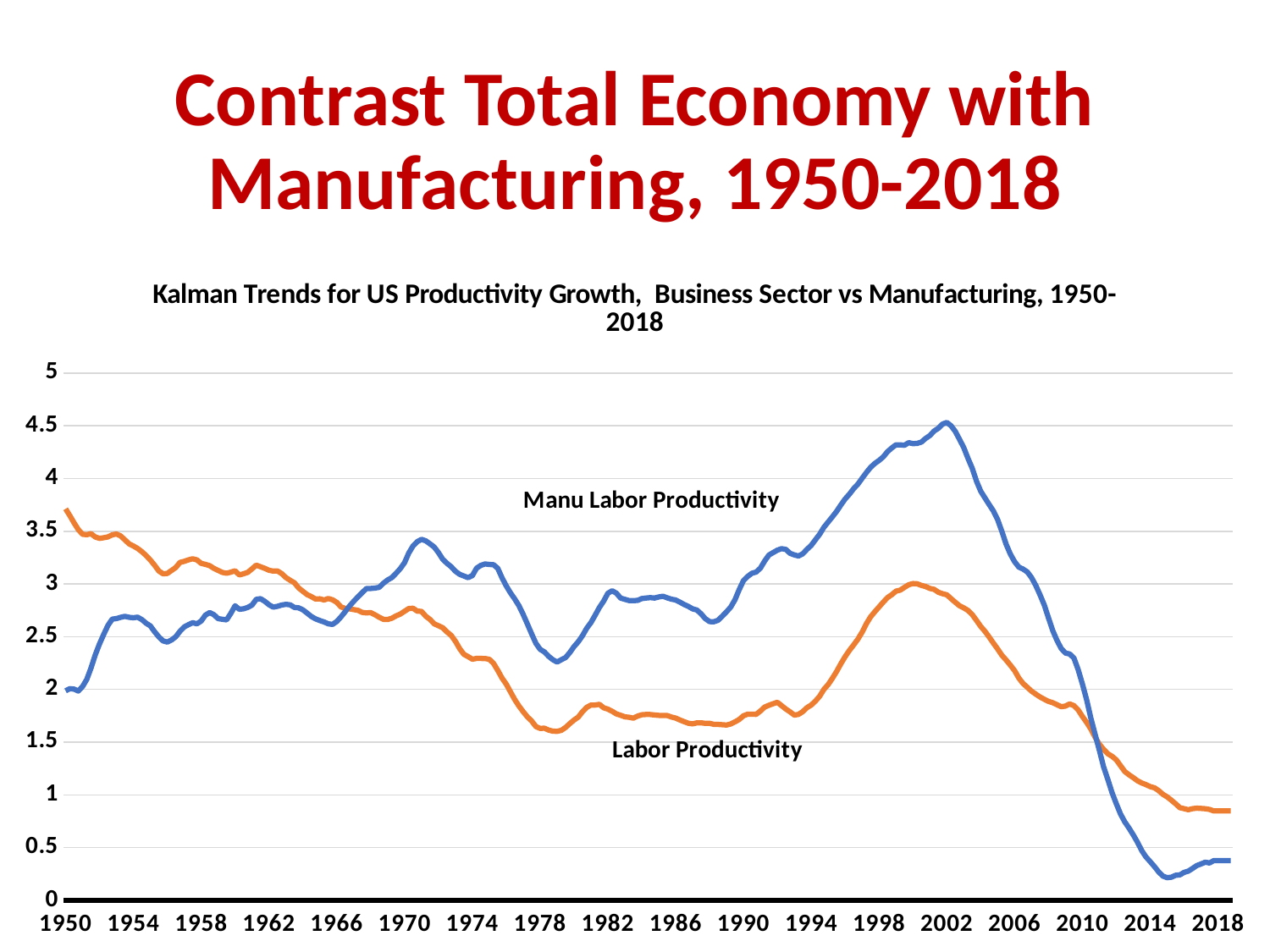
Is the value for Manu Labor Productivity in 2014 greater or less than 1? less Is the value for Manu Labor Productivity in 2002 greater or less than 4? greater In 2014, which series has the higher value, Manu Labor Productivity or Labor Productivity? Labor Productivity What kind of chart is shown on the slide? line chart How many lines (series) are plotted on the chart? 2 Is the value for Labor Productivity in 2018 greater or less than 1? less Does the Manu Labor Productivity line rise or fall between 2002 and 2014? fall Does the Labor Productivity line rise or fall between 1950 and 1978? fall In 2002, which series has the higher value, Manu Labor Productivity or Labor Productivity? Manu Labor Productivity What colour is the Manu Labor Productivity line? blue What is the title of the chart? Kalman Trends for US Productivity Growth, Business Sector vs Manufacturing, 1950-2018